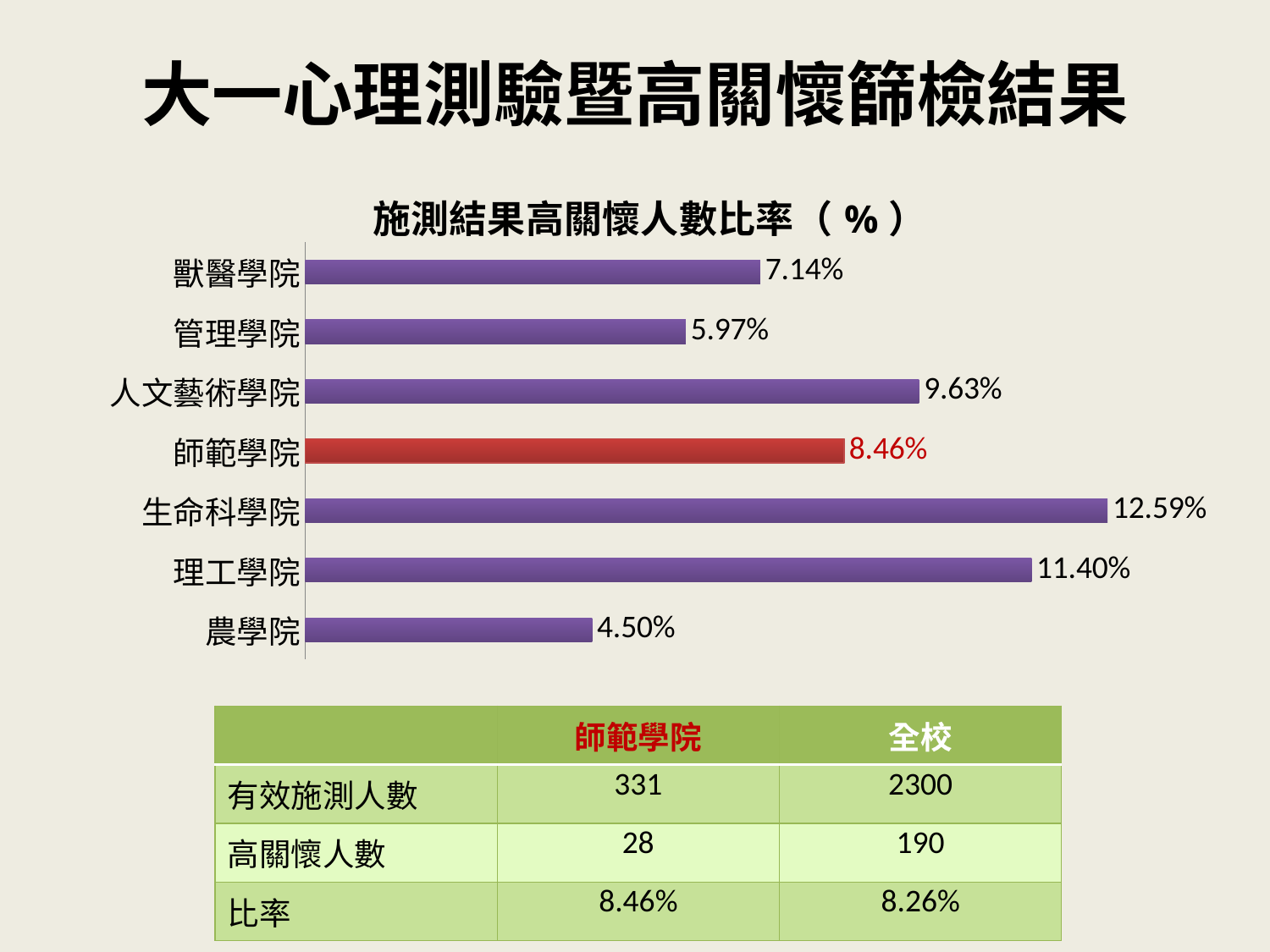
Which college has the lowest value in the chart? 農學院 What is the value for 師範學院 in the chart? 8.46% What is the value for 獸醫學院 in the chart? 7.14% How many colleges are shown in the chart? 7 What is the difference between the values for 生命科學院 and 理工學院? 1.19% Which college's bar is coloured red in the chart? 師範學院 Which is larger, the value for 人文藝術學院 or the value for 獸醫學院? 人文藝術學院 What kind of chart is shown on the slide? Bar chart What is the value for 理工學院 in the chart? 11.40% What is the difference between the values for 師範學院 and 管理學院? 2.49% What is the value for 農學院 in the chart? 4.50% Which college has the highest value in the chart? 生命科學院